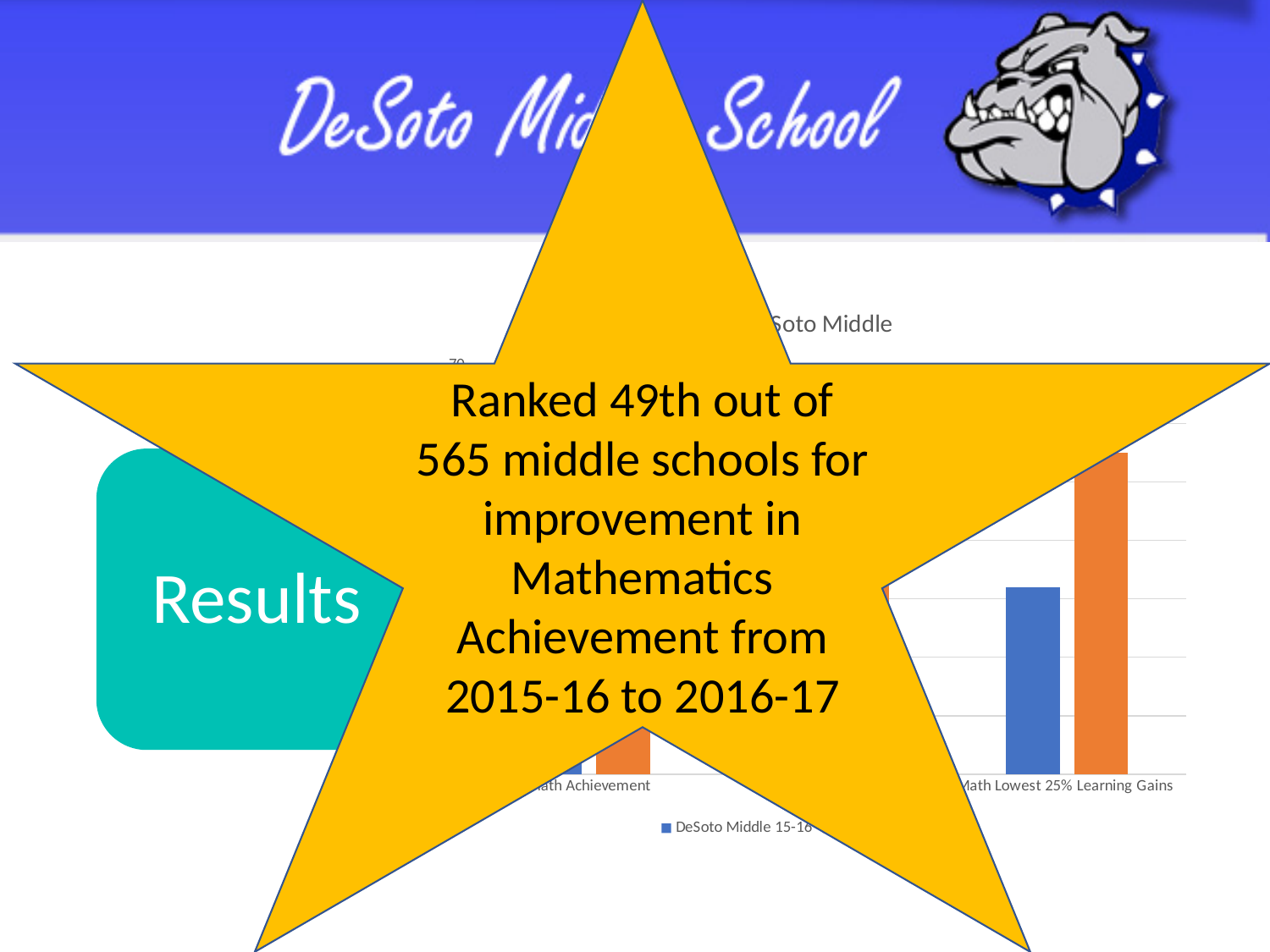
What colour are the bars for the DeSoto Middle 15-16 series? blue What kind of chart is shown on the slide? bar chart For Math Lowest 25% Learning Gains, which bar is taller, the blue one or the orange one? orange Which series does the blue bar represent according to the legend? DeSoto Middle 15-16 For Math Lowest 25% Learning Gains, is the blue bar (DeSoto Middle 15-16) taller or shorter than the orange bar? shorter